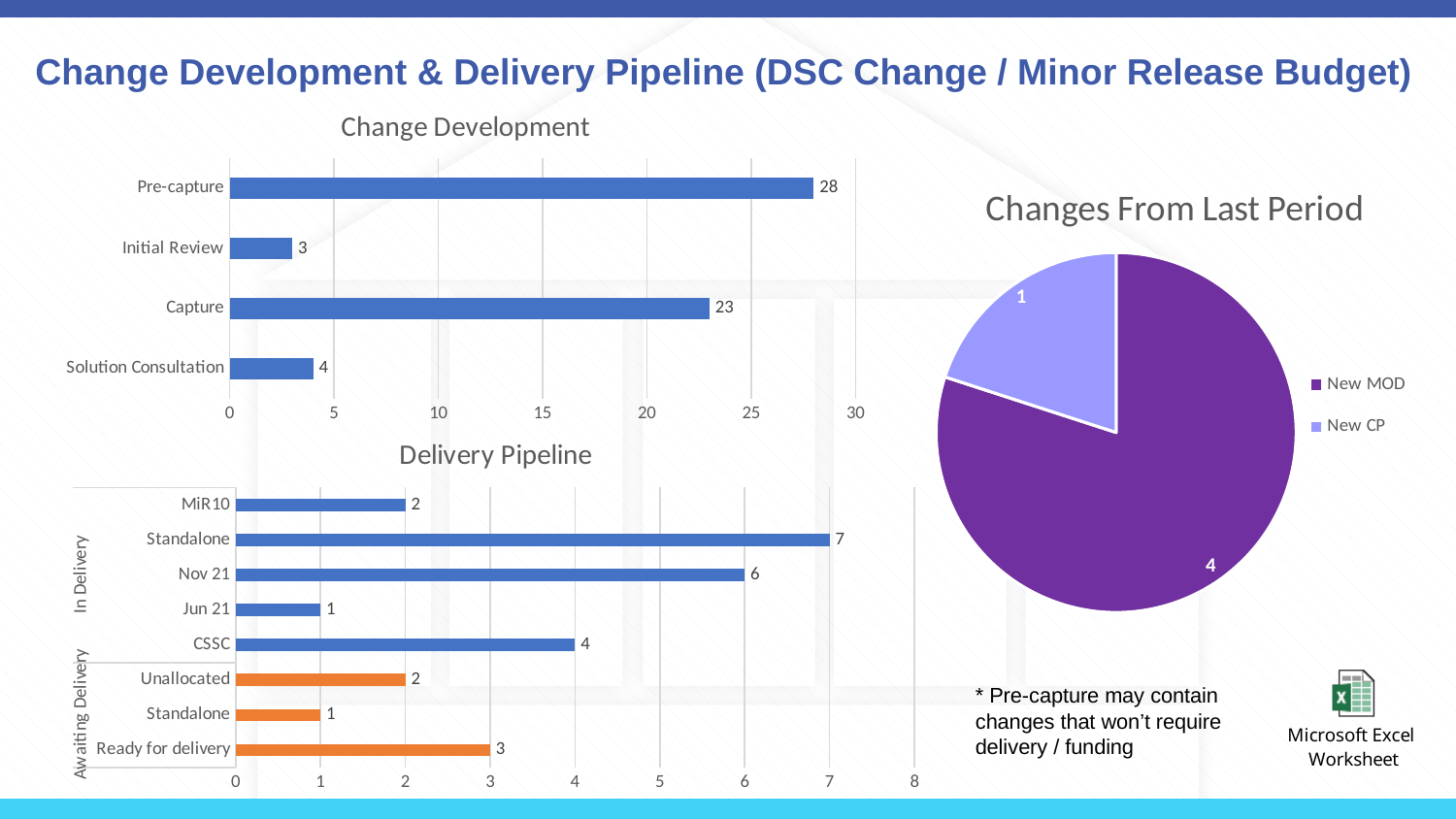
In the Delivery Pipeline chart, what is the total of the Awaiting Delivery categories (Unallocated, Standalone, Ready for delivery)? 6 In the Change Development chart, what is the difference between Pre-capture and Capture? 5 In the Change Development chart, what is the value for Pre-capture? 28 What kind of chart is the Delivery Pipeline chart? Bar chart In the Change Development chart, how many categories are shown? 4 How many series does the legend of the Changes From Last Period chart list? 2 In the Delivery Pipeline chart, which is larger, CSSC or Ready for delivery? CSSC In the Changes From Last Period chart, what share of the pie does New MOD represent? 80% In the Delivery Pipeline chart, which category has the highest value? Standalone (In Delivery) In the Change Development chart, which category has the lowest value? Initial Review In the Changes From Last Period chart, what is the value for New MOD? 4 In the Delivery Pipeline chart, what is the value for Nov 21? 6